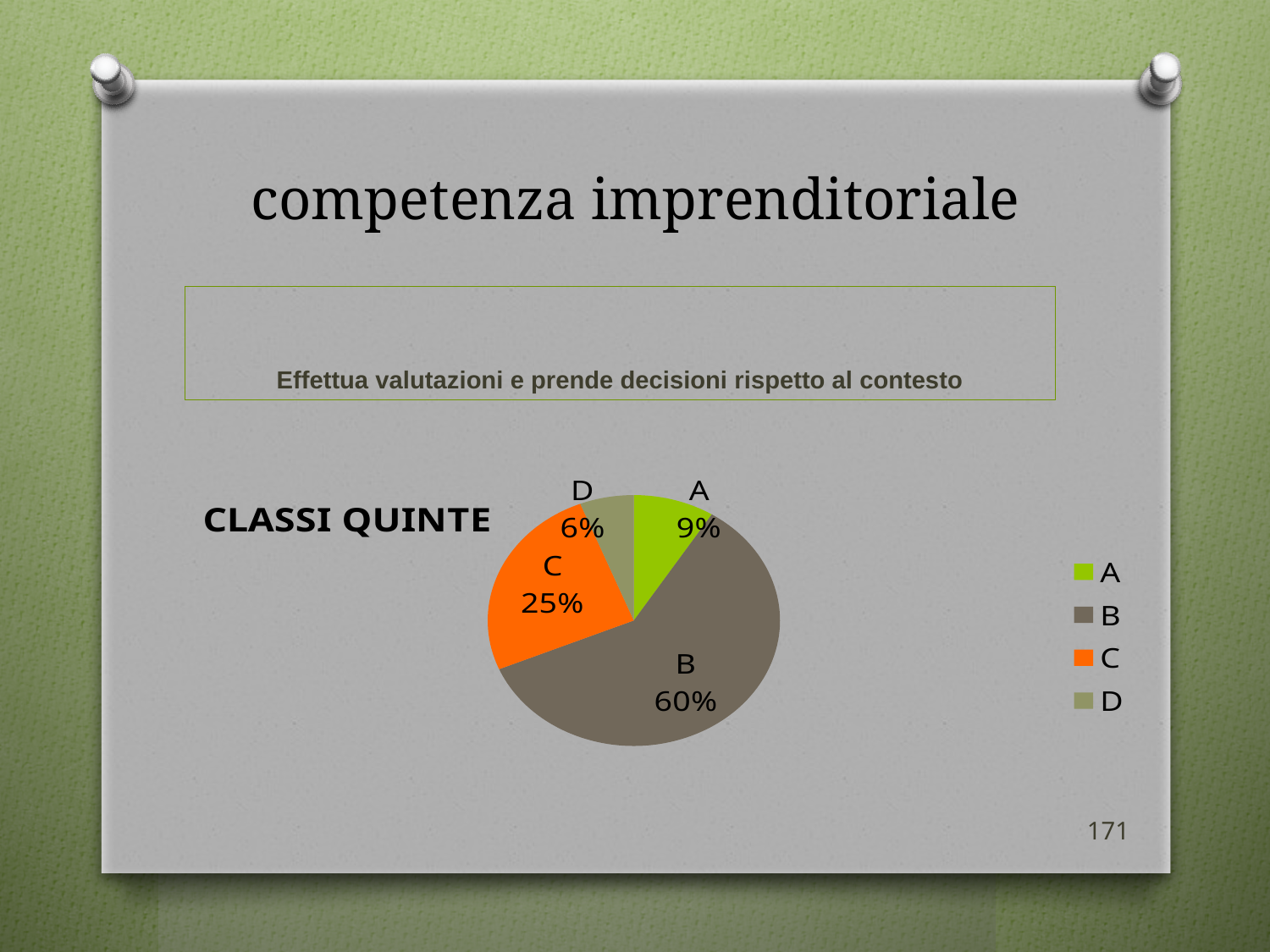
What percentage does slice B represent in the pie chart? 60% What percentage does slice A represent in the pie chart? 9% What colour is slice C in the pie chart? Orange What percentage does slice D represent in the pie chart? 6% Which category has the largest share of the pie chart? B Which category has the smallest share of the pie chart? D How many slices does the pie chart have? 4 What type of chart is shown on the slide? Pie chart What percentage does slice C represent in the pie chart? 25% Which slice is larger, A or C? C How many entries does the legend list? 4 What is the difference in percentage points between slice B and slice C? 35